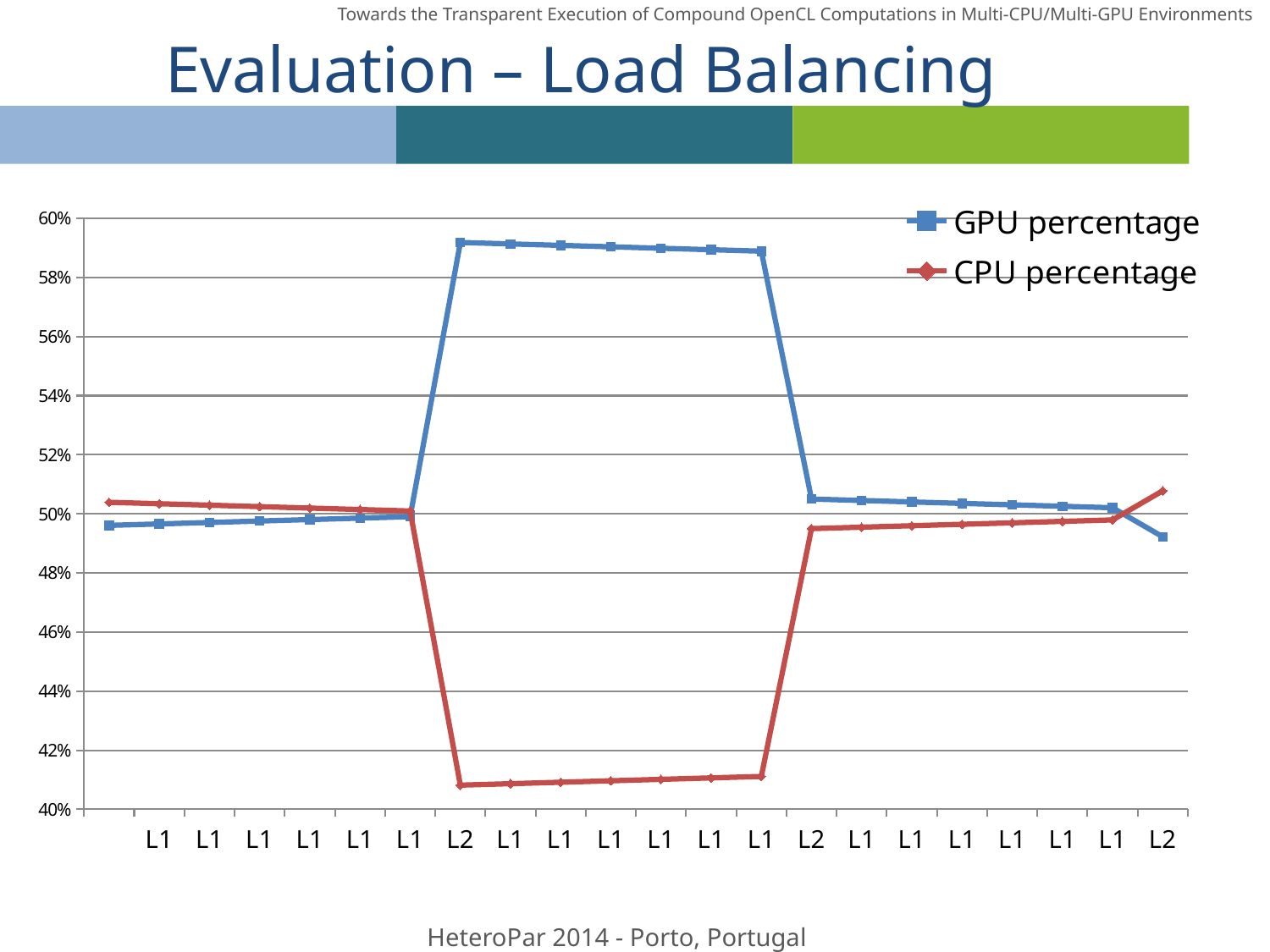
How many series does the legend list? 2 At the last L2 point, which is larger, GPU percentage or CPU percentage? CPU percentage Which series reaches the lowest value on the chart? CPU percentage Is the highest value of GPU percentage greater or less than 58%? greater At the first L2 point, is the GPU percentage greater or less than 56%? greater Which series reaches the highest value on the chart? GPU percentage Is the lowest value of CPU percentage greater or less than 42%? less What is the highest value shown on the y axis? 60% At the first L2 point, which is larger, GPU percentage or CPU percentage? GPU percentage What kind of chart is shown on the slide? line chart What are the two series named in the legend? GPU percentage and CPU percentage